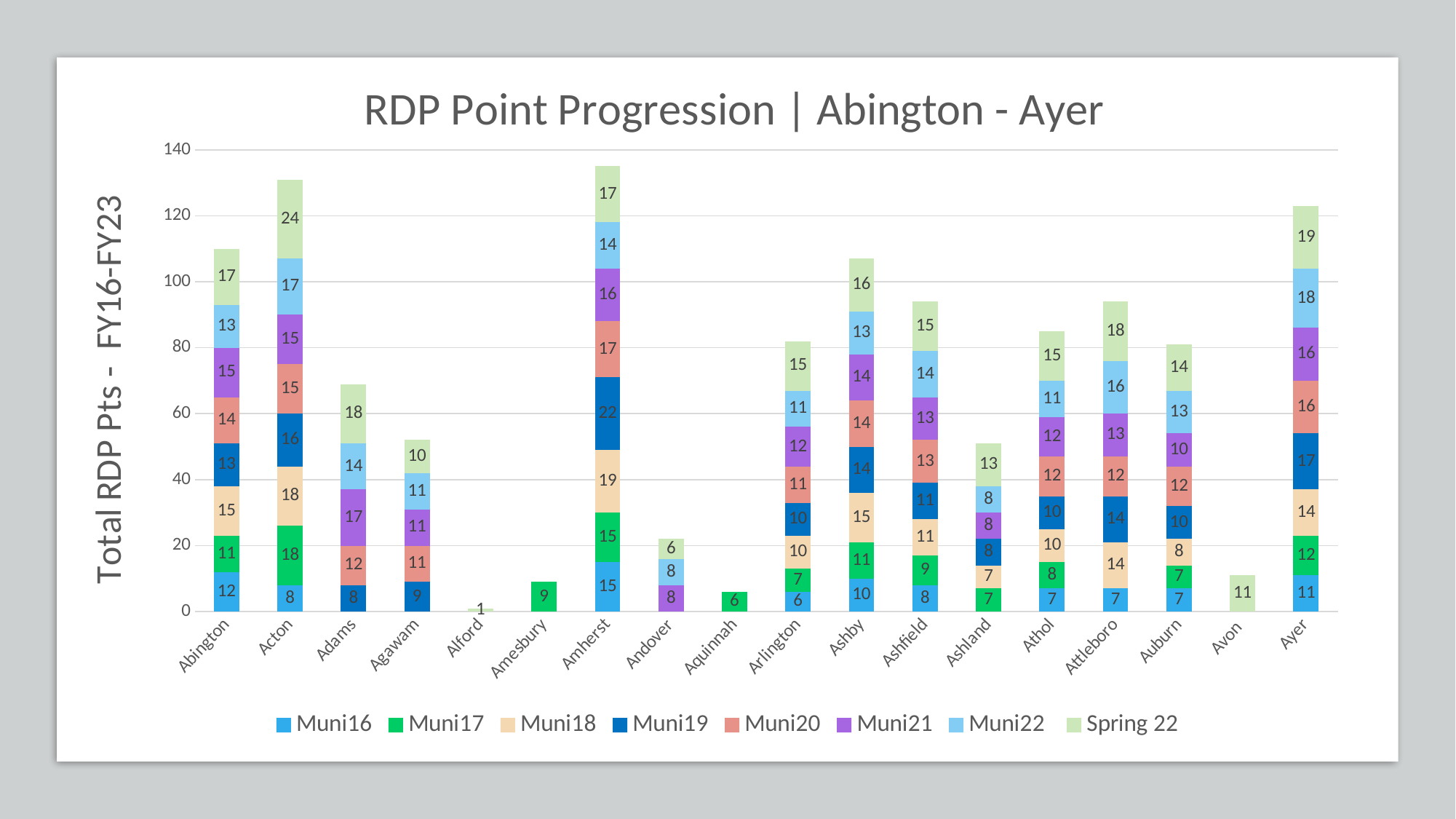
What is the Muni21 value for Adams? 17 Which municipality has the shortest stacked bar overall? Alford How many series does the legend list? 8 What is the Muni19 value for Amherst? 22 How many municipalities are shown on the x axis? 18 What is the title of the chart? RDP Point Progression | Abington - Ayer What is the Spring 22 value for Acton? 24 What type of chart is shown on the slide? Stacked bar chart What is the total of the stacked bar for Abington? 110 What is the difference between the Spring 22 values for Ayer and Avon? 8 Which municipality has the tallest stacked bar overall? Amherst Is the total stacked bar for Ashby greater or less than 100? greater